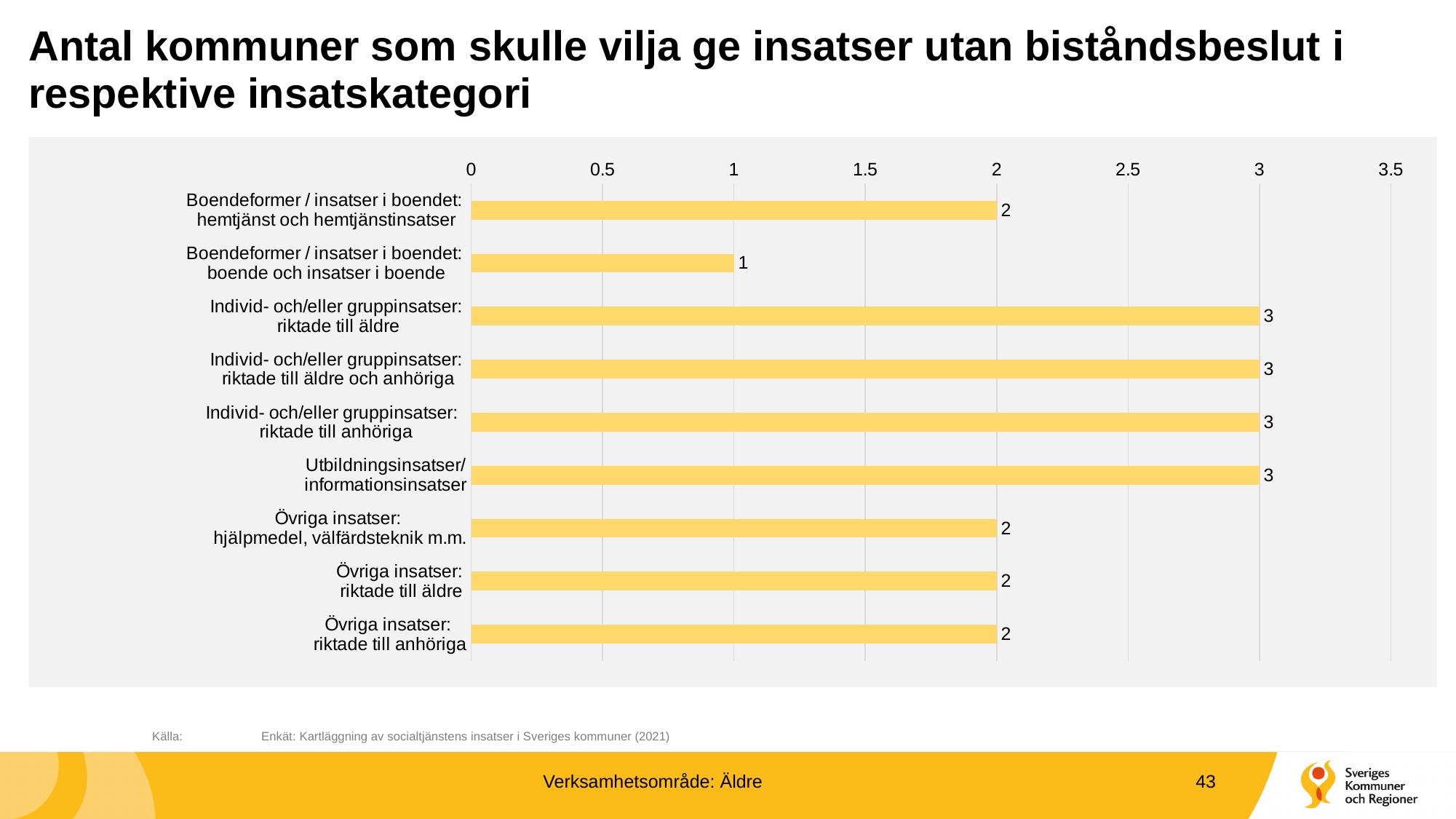
What is the value for 'Boendeformer / insatser i boendet: boende och insatser i boende'? 1 Which is larger: the value for 'Individ- och/eller gruppinsatser: riktade till anhöriga' or the value for 'Övriga insatser: riktade till äldre'? Individ- och/eller gruppinsatser: riktade till anhöriga How many categories are shown in the chart? 9 What is the value for 'Utbildningsinsatser/informationsinsatser'? 3 What is the highest value shown on the x axis? 3.5 What is the value for 'Boendeformer / insatser i boendet: hemtjänst och hemtjänstinsatser'? 2 Is the value for 'Övriga insatser: hjälpmedel, välfärdsteknik m.m.' greater or less than 2.5? less What is the value for 'Övriga insatser: riktade till anhöriga'? 2 What is the difference between the value for 'Individ- och/eller gruppinsatser: riktade till äldre' and the value for 'Boendeformer / insatser i boendet: boende och insatser i boende'? 2 Which category has the lowest value? Boendeformer / insatser i boendet: boende och insatser i boende How many categories have a value of 3? 4 What kind of chart is shown on the slide? Bar chart